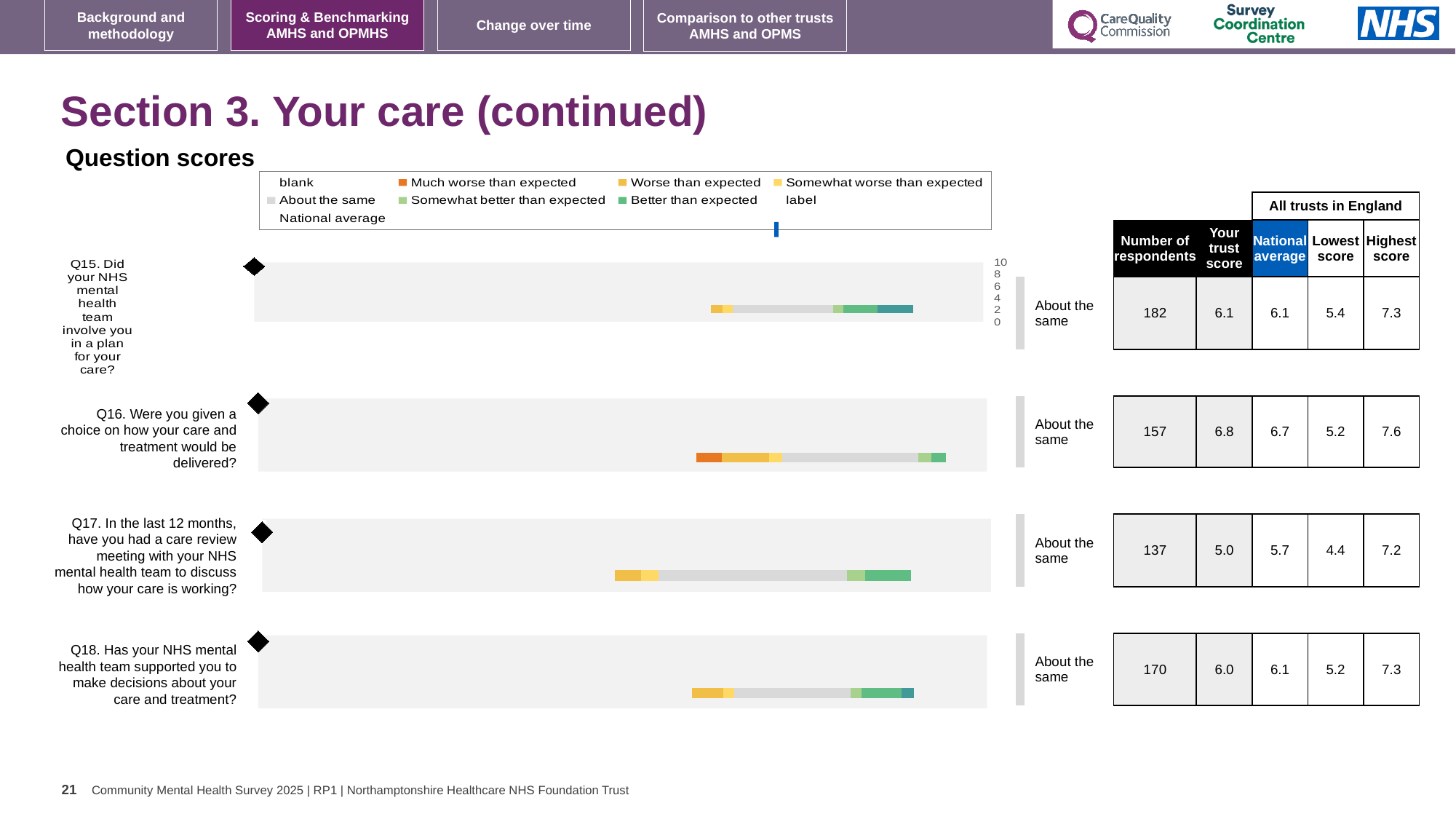
What is the lowest score across all trusts in England for Q17? 4.4 How many questions are plotted on the chart? 4 What is the highest score across all trusts in England for Q16? 7.6 How many respondents are shown for Q16? 157 Which question has the lowest trust score? Q17 What benchmark label is shown next to the bar for Q15? About the same Which question has the highest trust score? Q16 Which question has the most respondents? Q15 What is the national average for Q18? 6.1 What is the difference between the national average and the trust score for Q17? 0.7 Which is larger, the trust score for Q16 or the trust score for Q18? Q16 What is the trust score for Q17? 5.0